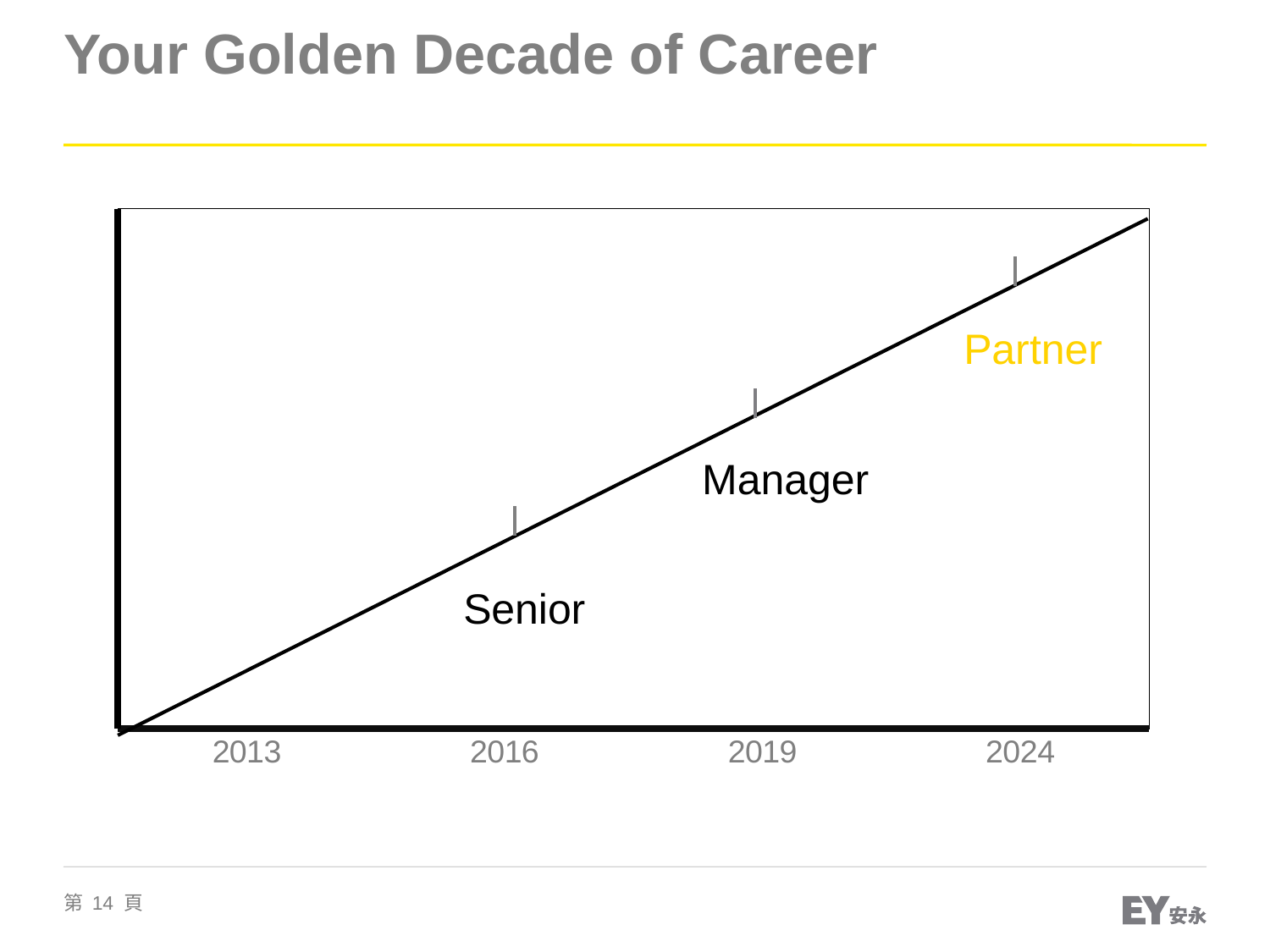
Which career stage is marked near 2024 on the x axis? Partner Which career stage is marked at the highest point on the line? Partner Which is higher on the line, the Manager mark or the Senior mark? Manager What colour is the "Partner" label on the chart? yellow What kind of chart is shown on the slide? line chart How many career stages are marked along the line? 3 Which career stage is marked near 2016 on the x axis? Senior What is the title of the slide containing the chart? Your Golden Decade of Career Which career stage is marked at the lowest point on the line? Senior Which career stage is marked near 2019 on the x axis? Manager Does the line rise or fall from 2013 to 2024? rises How many year labels are shown on the x axis? 4